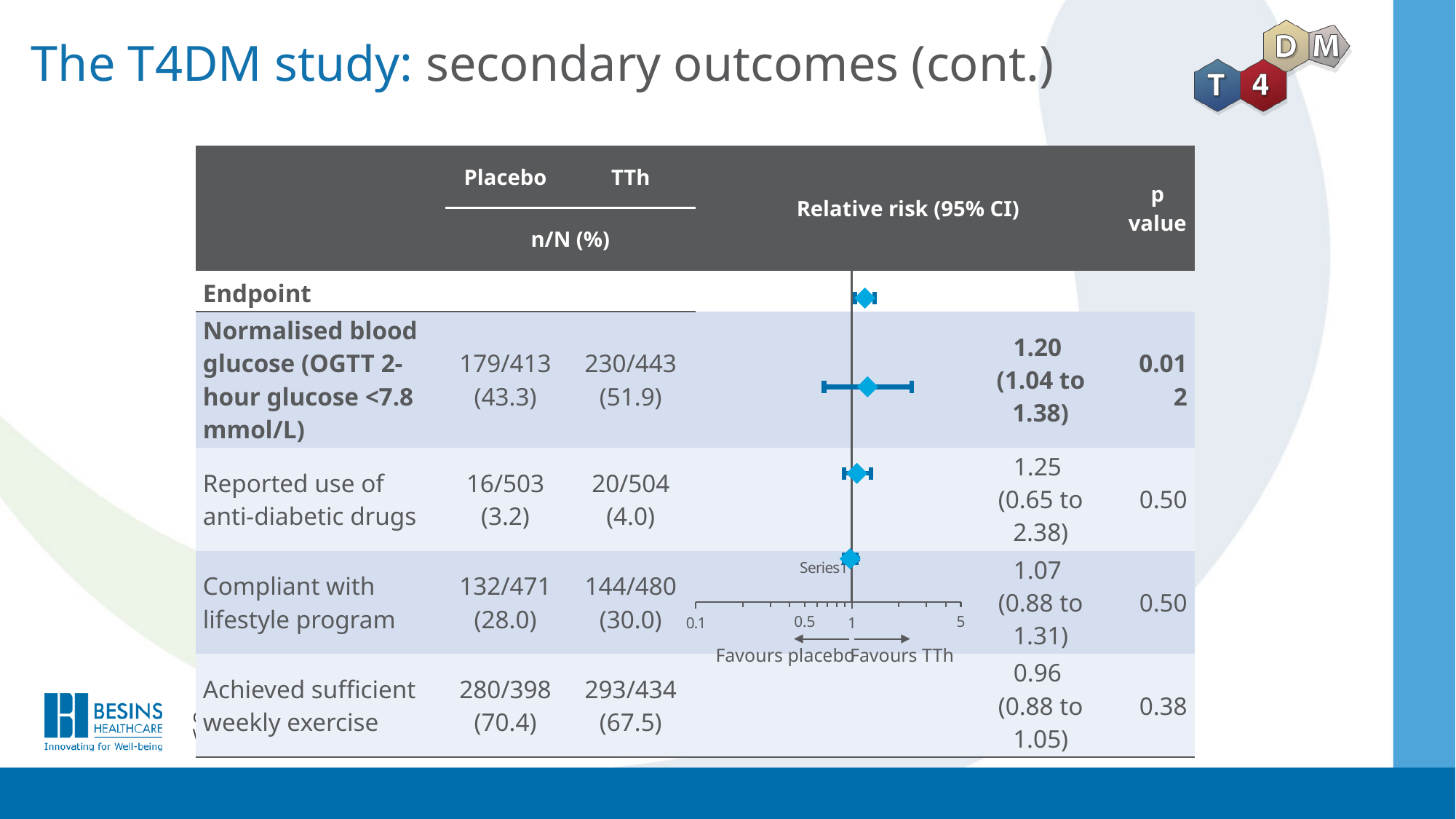
What kind of chart is shown in the 'Relative risk (95% CI)' column? Forest plot (points with error bars) How many series does the chart legend list? 1 Is the relative risk for 'Achieved sufficient weekly exercise' greater or less than 1? less What is the relative risk plotted for the 'Normalised blood glucose' endpoint? 1.20 Which has the larger relative risk: 'Normalised blood glucose' or 'Compliant with lifestyle program'? Normalised blood glucose What does the right-pointing arrow below the x axis of the forest plot indicate? Favours TTh What is the 95% confidence interval for the relative risk of 'Achieved sufficient weekly exercise'? 0.88 to 1.05 Which endpoint has the lowest relative risk point estimate? Achieved sufficient weekly exercise How many endpoints are plotted as points in the forest plot? 4 What is the difference between the relative risk for 'Reported use of anti-diabetic drugs' and 'Achieved sufficient weekly exercise'? 0.29 What is the relative risk for 'Reported use of anti-diabetic drugs'? 1.25 Which endpoint has the highest relative risk point estimate? Reported use of anti-diabetic drugs